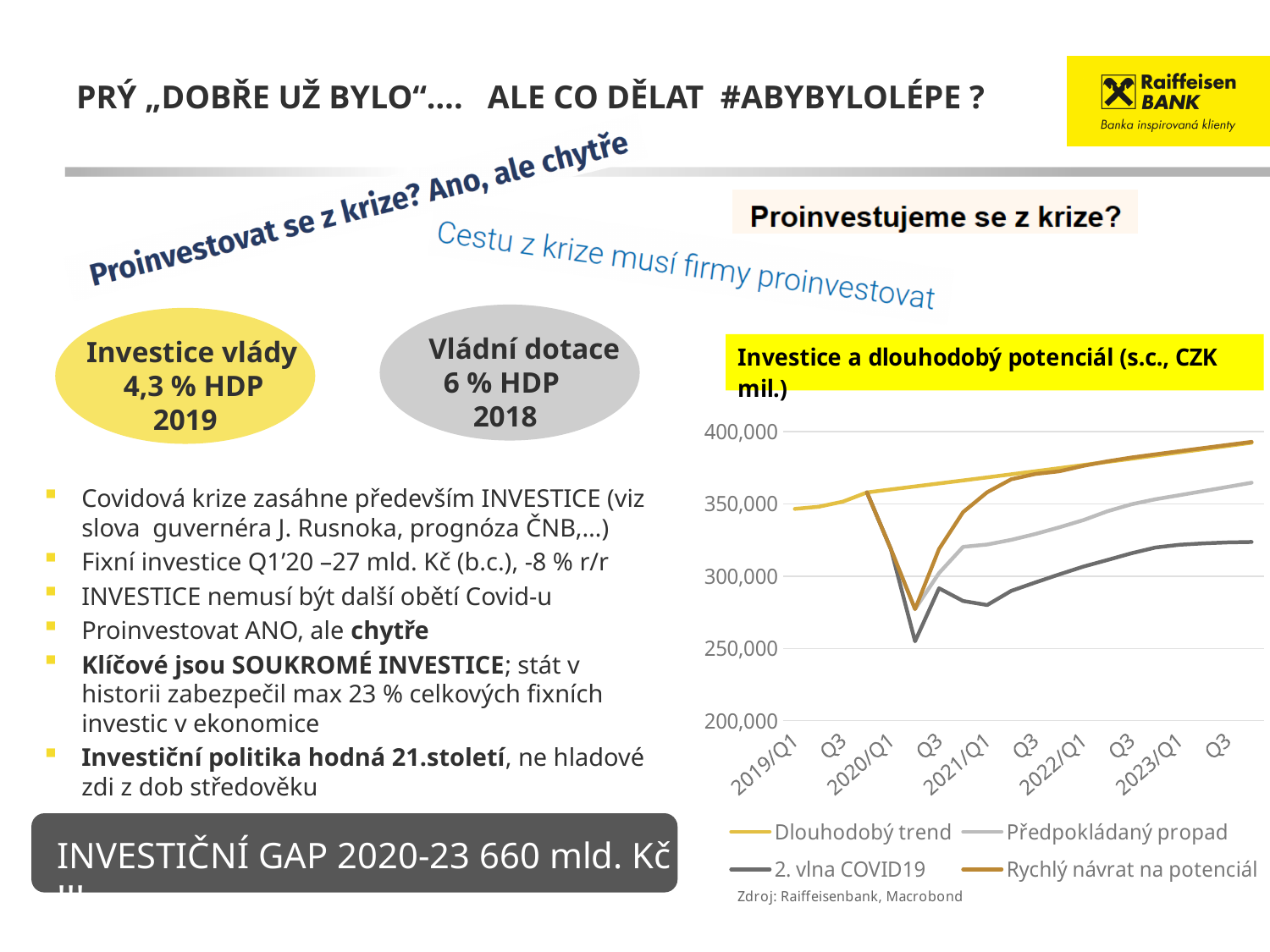
Which series in the chart is drawn in yellow? Dlouhodobý trend Is the value of the Dlouhodobý trend series at 2023/Q3 greater or less than 350,000? greater At 2023/Q3, which series is higher: Dlouhodobý trend or 2. vlna COVID19? Dlouhodobý trend What is the title of the chart? Investice a dlouhodobý potenciál (s.c., CZK mil.) Does the Dlouhodobý trend series rise or fall from 2019/Q1 to 2023/Q3? rise Which series in the chart falls to the lowest point? 2. vlna COVID19 How many series does the legend of the chart list? 4 How many labelled points are shown on the x axis of the chart? 10 Is the lowest value of the 2. vlna COVID19 series greater or less than 300,000? less Is the lowest value of the Rychlý návrat na potenciál series greater or less than 300,000? less What kind of chart is shown on the slide? line chart